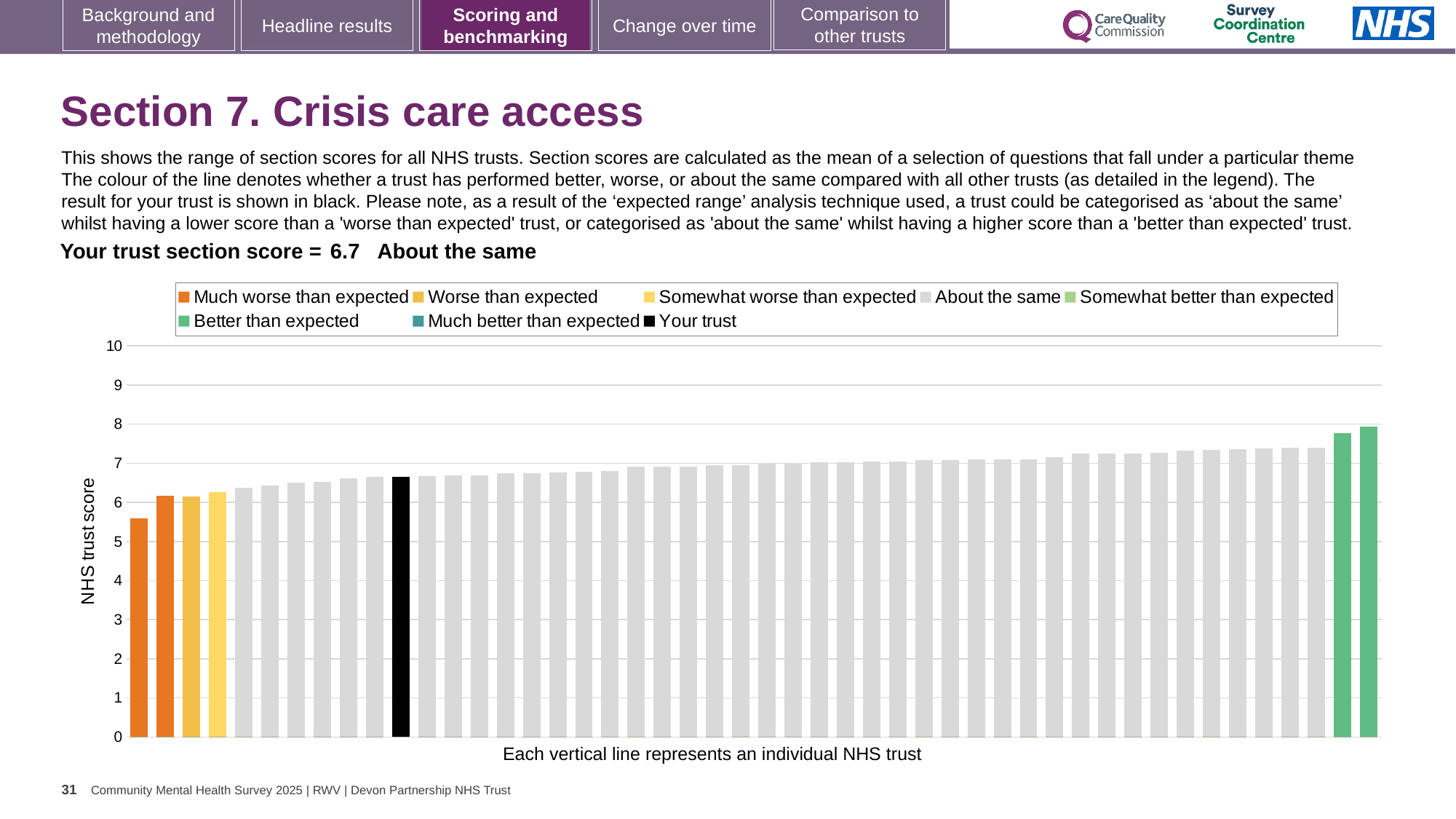
Which performance category is your trust placed in for crisis care access? About the same What colour is the bar representing your trust? black Do the bar values rise or fall from left to right along the x axis? rise How many entries does the chart legend list? 8 Is the value of the rightmost (highest) bar greater or less than 7? greater What is the highest value shown on the y axis? 10 Is the value of the leftmost (lowest) bar greater or less than 6? less How many bars are coloured orange for 'Much worse than expected'? 2 How many bars are coloured green for 'Better than expected'? 2 Is the value of the bar for your trust greater or less than 6? greater What kind of chart is shown on the slide? bar chart What is the section score for your trust shown on the slide? 6.7